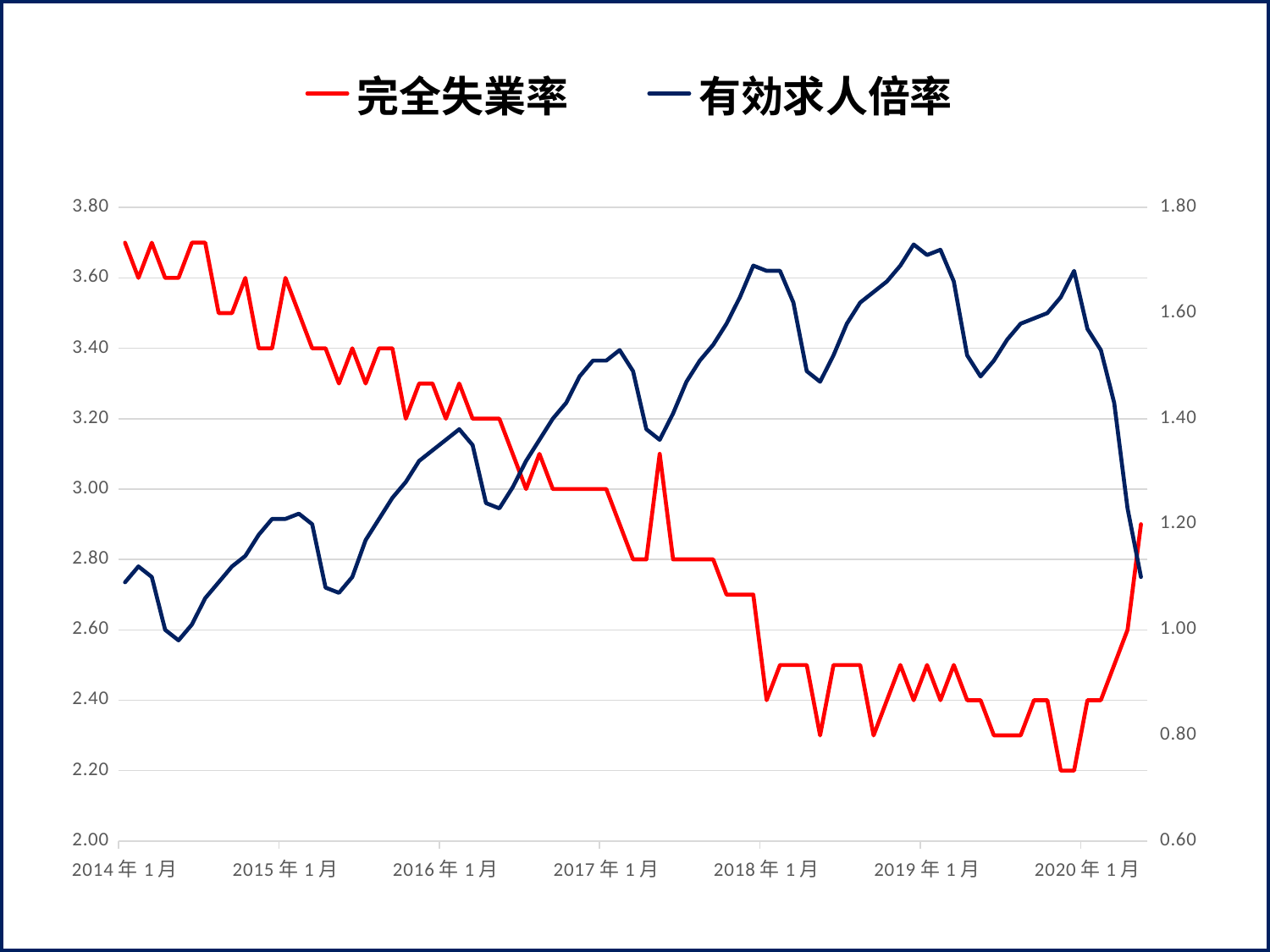
Is the value of 有効求人倍率 at 2018年1月 greater or less than 1.40? greater Is the value of 完全失業率 at 2018年1月 greater or less than 3.00? less Which is larger for 有効求人倍率: the value at 2014年1月 or the value at 2019年1月? 2019年1月 What colour is the line for 完全失業率? red From 2014年1月 to 2019年1月, does the 完全失業率 line generally rise or fall? fall Which series is drawn in dark blue? 有効求人倍率 How many series does the legend list? 2 What kind of chart is shown on the slide? line chart Is the value of 有効求人倍率 at 2014年1月 greater or less than 1.20? less How many year labels are shown on the x axis? 7 Which is larger for 完全失業率: the value at 2014年1月 or the value at 2020年1月? 2014年1月